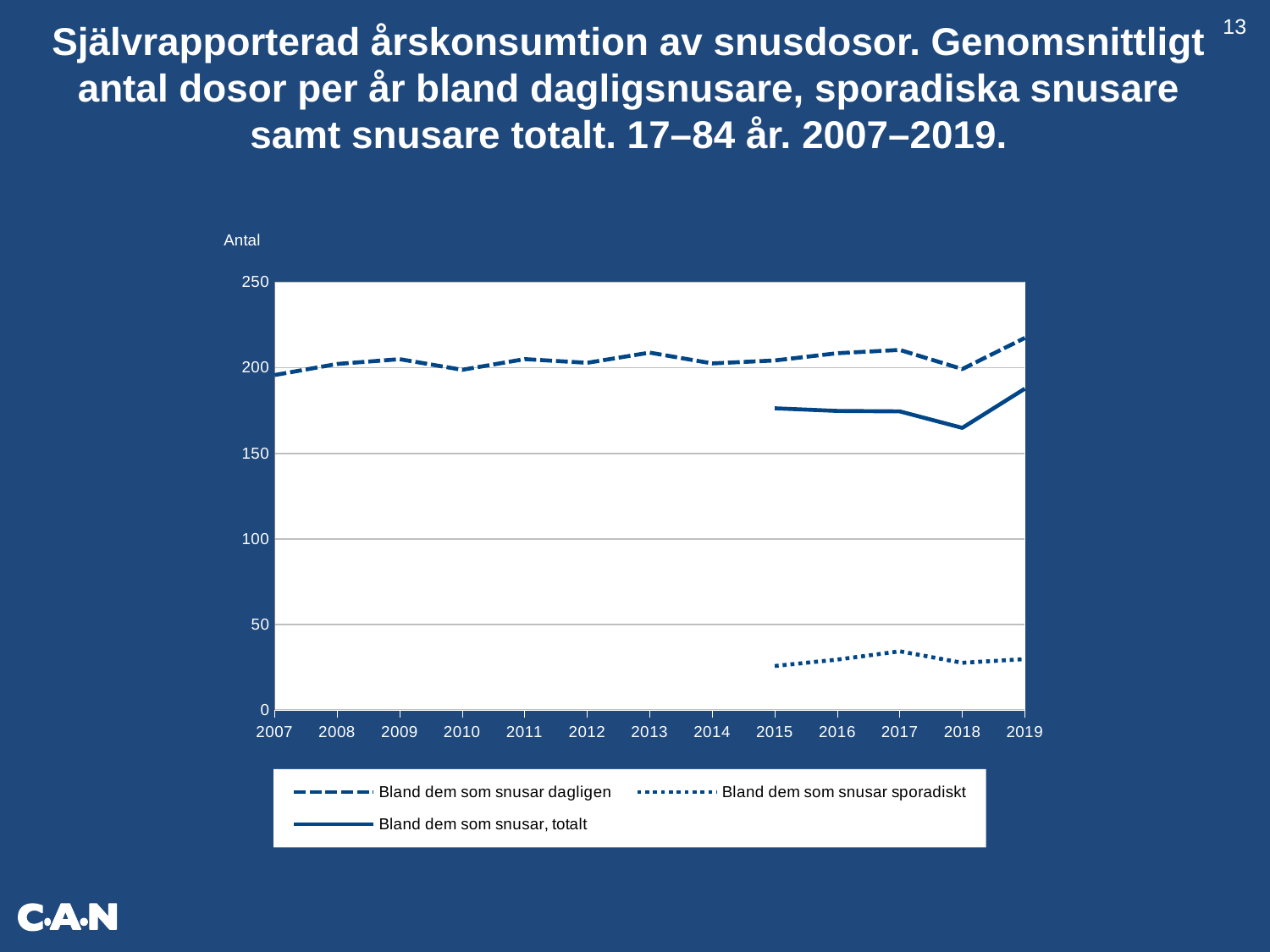
Is the value for 'Bland dem som snusar dagligen' in 2019 greater or less than 200? greater What label is shown on the y axis of the chart? Antal Is the value for 'Bland dem som snusar, totalt' in 2018 greater or less than 200? less How many series does the legend list? 3 In which year is the value for 'Bland dem som snusar, totalt' lowest? 2018 Is the value for 'Bland dem som snusar, totalt' in 2015 greater or less than 150? greater Does the value for 'Bland dem som snusar, totalt' rise or fall from 2018 to 2019? rise How many years are shown on the x axis? 13 In 2019, which is larger: 'Bland dem som snusar dagligen' or 'Bland dem som snusar, totalt'? Bland dem som snusar dagligen Which series has the highest values across the chart? Bland dem som snusar dagligen What kind of chart is shown on the slide? line chart